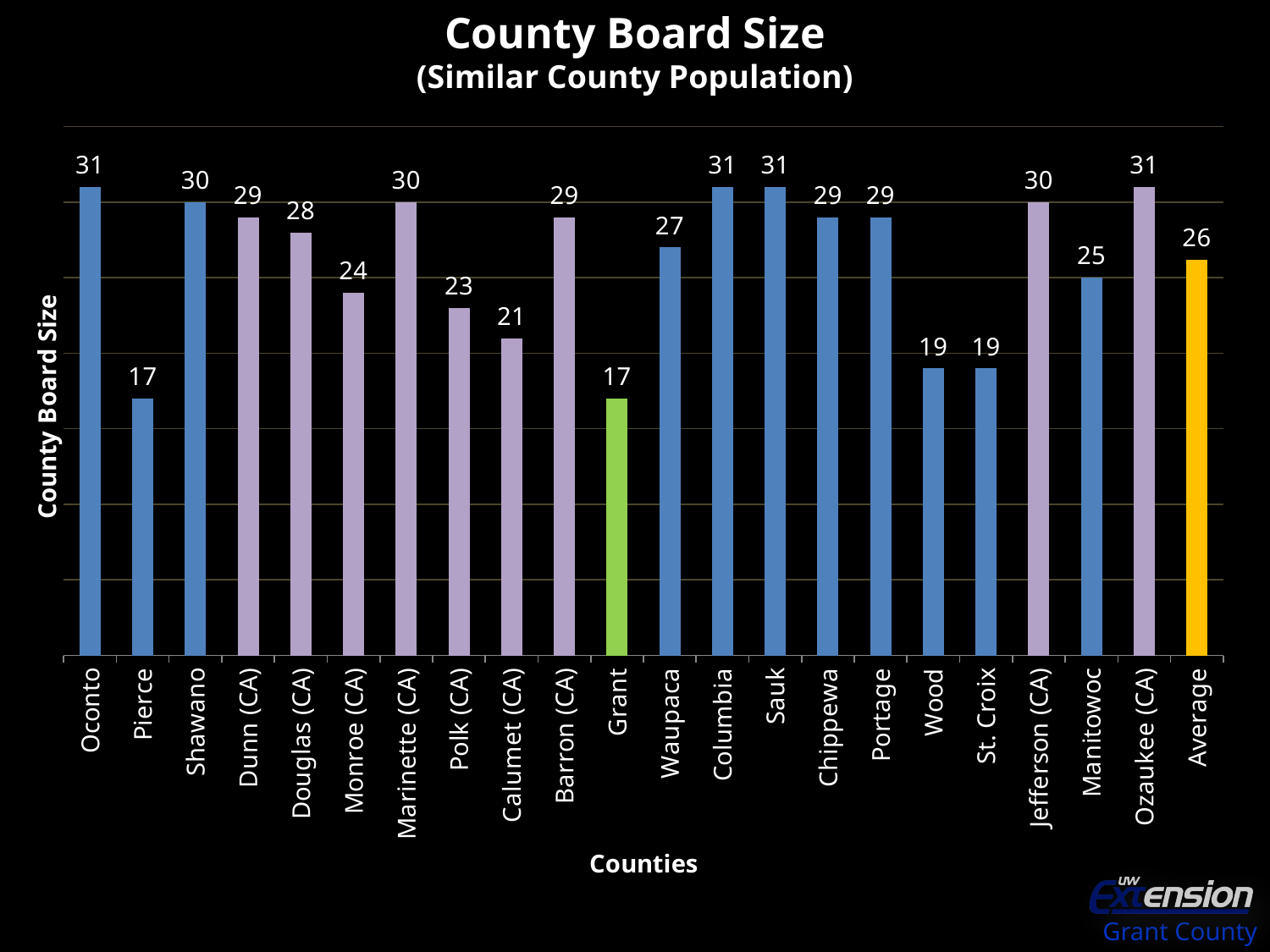
How many bars are plotted on the chart, including the Average bar? 22 Which has a larger county board size, Manitowoc or Jefferson (CA)? Jefferson (CA) What colour is the bar for Grant? Green What is the county board size for Grant? 17 What type of chart is shown on the slide? Bar chart What is the largest county board size shown on the chart? 31 Which has a larger county board size, Polk (CA) or Douglas (CA)? Douglas (CA) How much larger is the Average value than the value for Grant? 9 What is the county board size for Monroe (CA)? 24 What is the difference between the board sizes of Oconto and Pierce? 14 What is the county board size for Waupaca? 27 What value is shown for the Average bar? 26